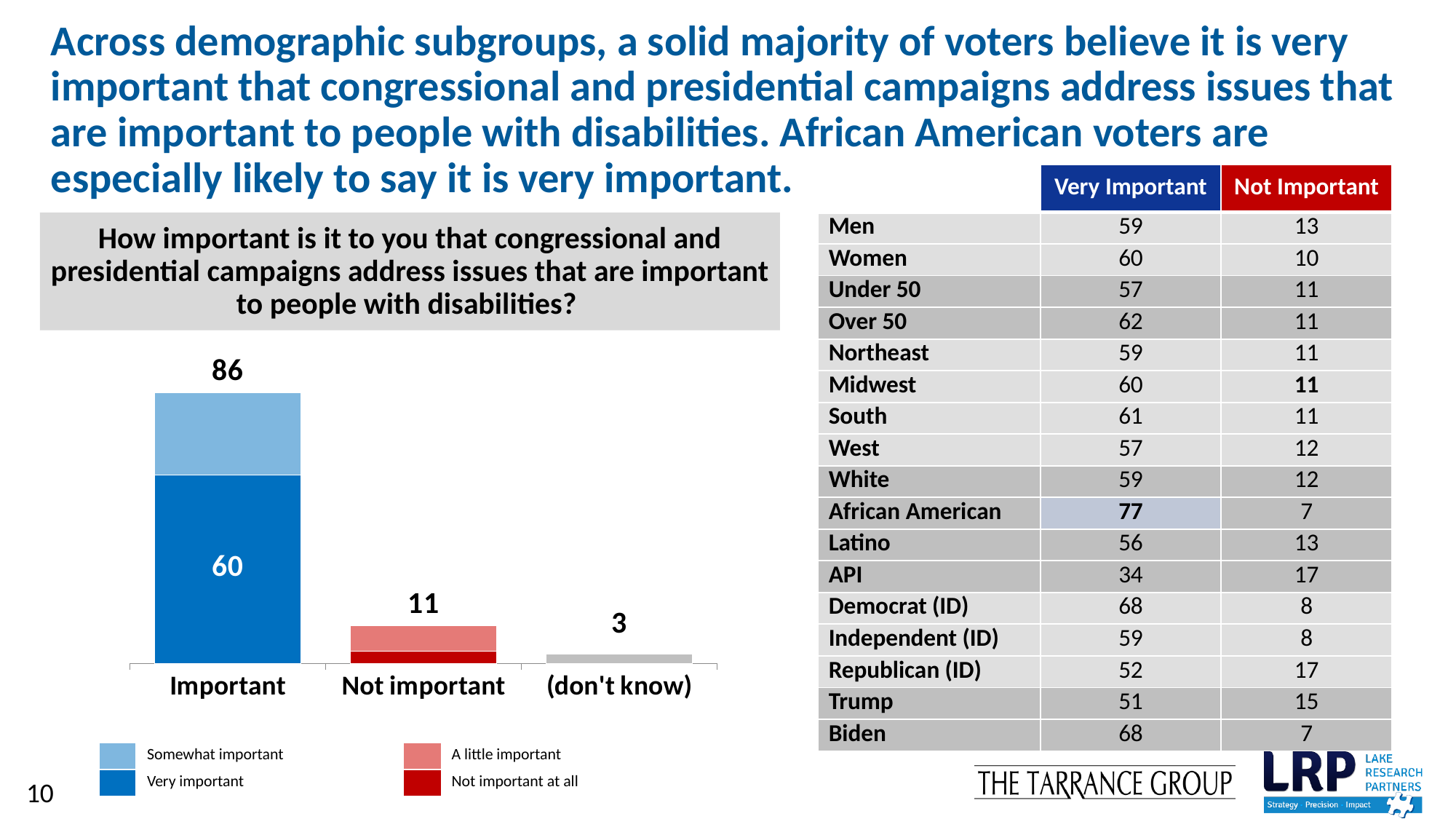
Which category has the highest value in the chart? Important How many entries does the chart legend list? 4 What is the value of the "Very important" segment in the "Important" bar? 60 Which is larger, the "Not important" bar or the "(don't know)" bar? Not important What is the value shown for the "Not important" bar? 11 How many categories are shown on the x axis of the chart? 3 What is the value shown for the "(don't know)" bar? 3 What is the difference between the "Important" total (86) and the "Not important" value (11)? 75 What kind of chart is shown on the slide? Stacked bar chart Which category has the lowest value in the chart? (don't know) What is the total value of the "Important" bar? 86 Based on the printed labels, what is the value of the "Somewhat important" segment (86 total minus 60 very important)? 26